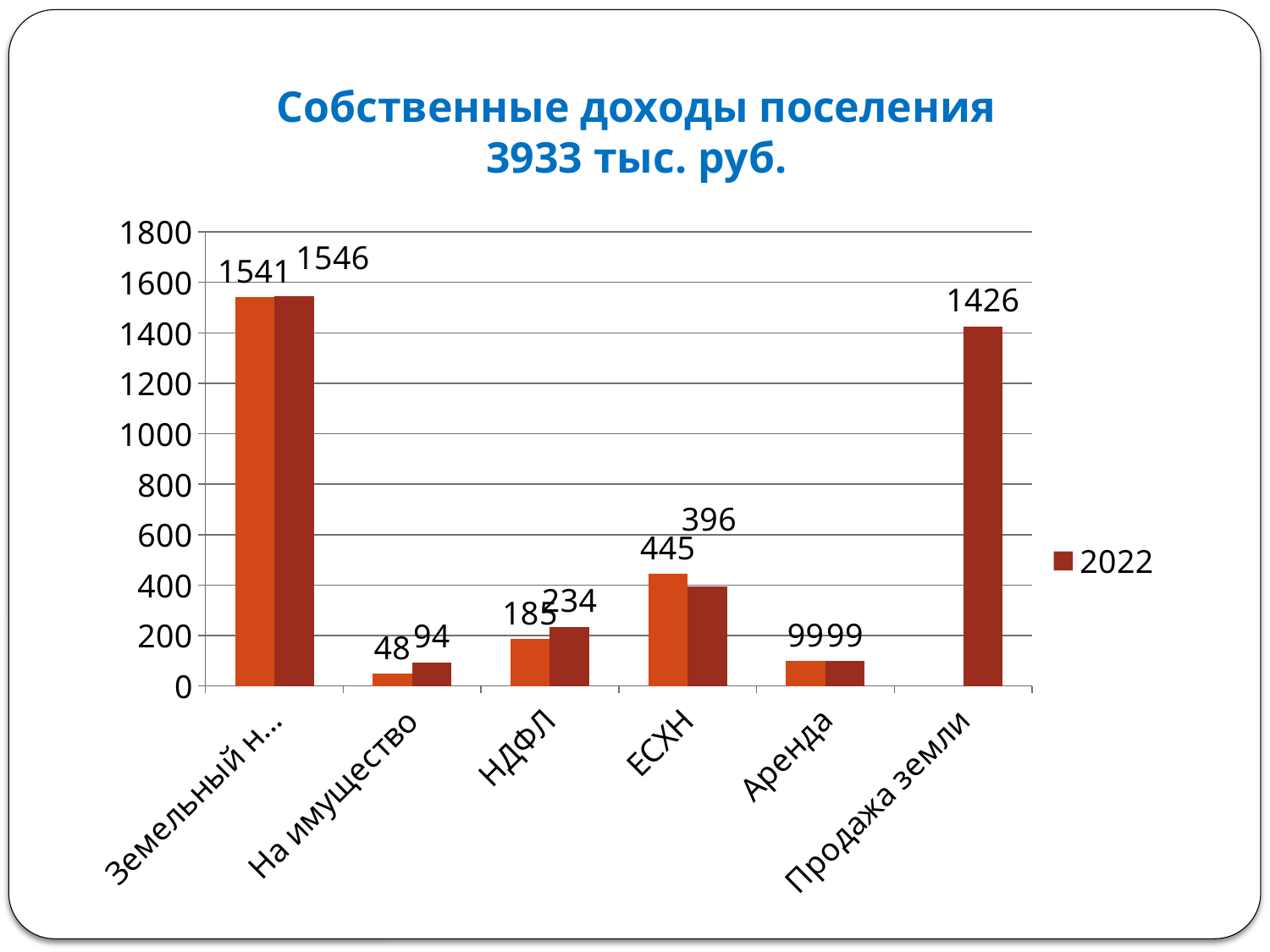
What is the 2022 value for Продажа земли? 1426 What is the difference between the 2022 values for НДФЛ and На имущество? 140 Which category has the lowest 2022 value? На имущество Which has the larger 2022 value, ЕСХН or НДФЛ? ЕСХН What is the 2022 value for Аренда? 99 What kind of chart is shown on the slide? Bar chart How many categories are shown on the x axis? 6 What is the 2022 value for На имущество? 94 How many series does the legend list? 1 What is the 2022 value for НДФЛ? 234 What is the 2022 value for ЕСХН? 396 What is the difference between the 2022 values for Продажа земли and ЕСХН? 1030